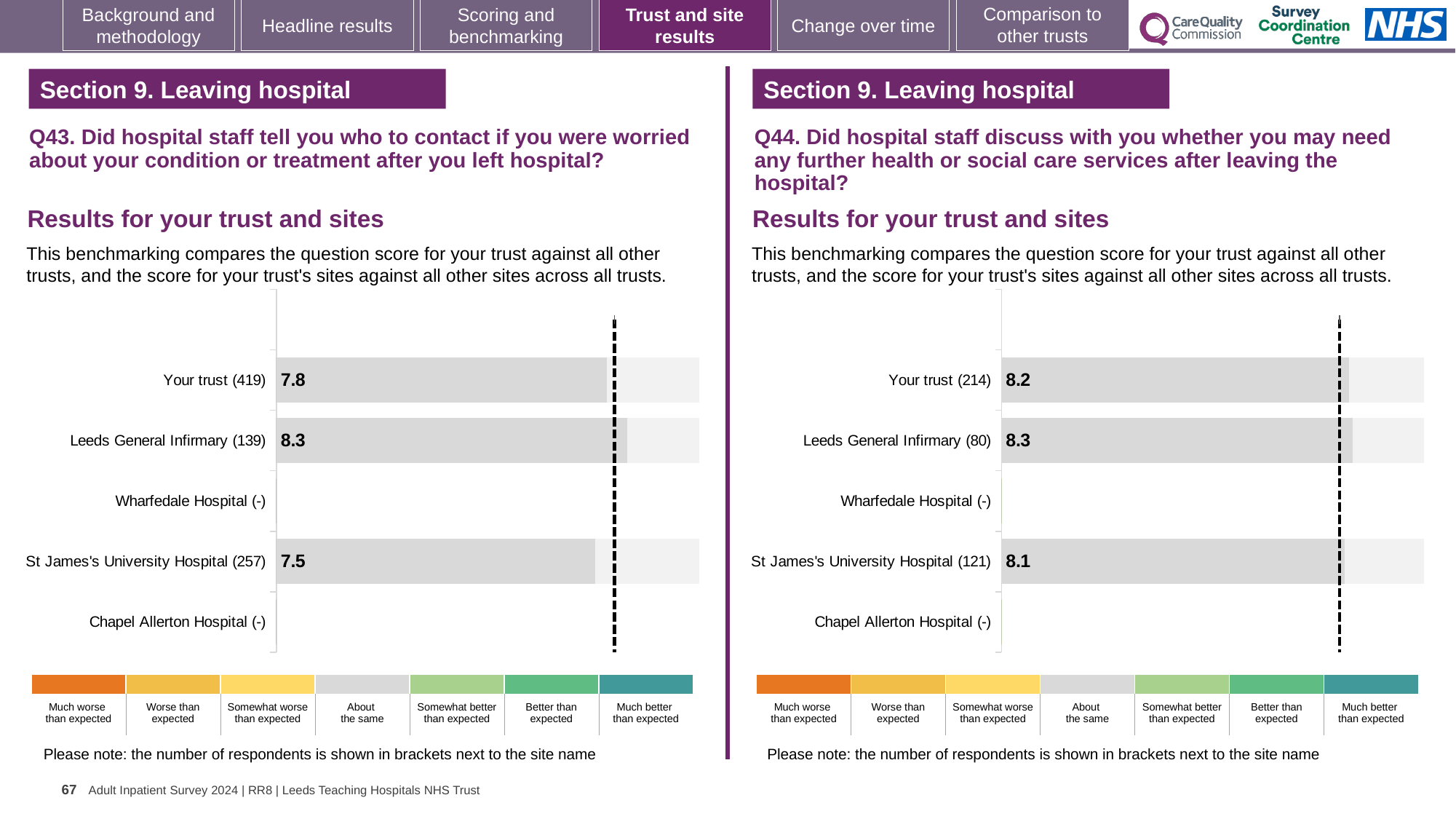
In the Q44 chart on the right, what is the score for Leeds General Infirmary? 8.3 In the Q44 chart on the right, what is the score for Your trust? 8.2 In the Q43 chart on the left, what is the score for St James's University Hospital? 7.5 How many site or trust rows are listed in the Q43 chart on the left? 5 In the Q43 chart on the left, what is the difference between the scores for Leeds General Infirmary and St James's University Hospital? 0.8 In the Q43 chart on the left, which site or trust has the highest score? Leeds General Infirmary In the Q43 chart on the left, what is the score for Your trust? 7.8 In the Q44 chart on the right, which has the lower score, Your trust or St James's University Hospital? St James's University Hospital In the Q44 chart on the right, what is the difference between the scores for Leeds General Infirmary and St James's University Hospital? 0.2 In the Q43 chart on the left, how many respondents are shown for Your trust? 419 In the Q44 chart on the right, how many respondents are shown for St James's University Hospital? 121 What kind of chart is used in the Q44 chart on the right? Bar chart